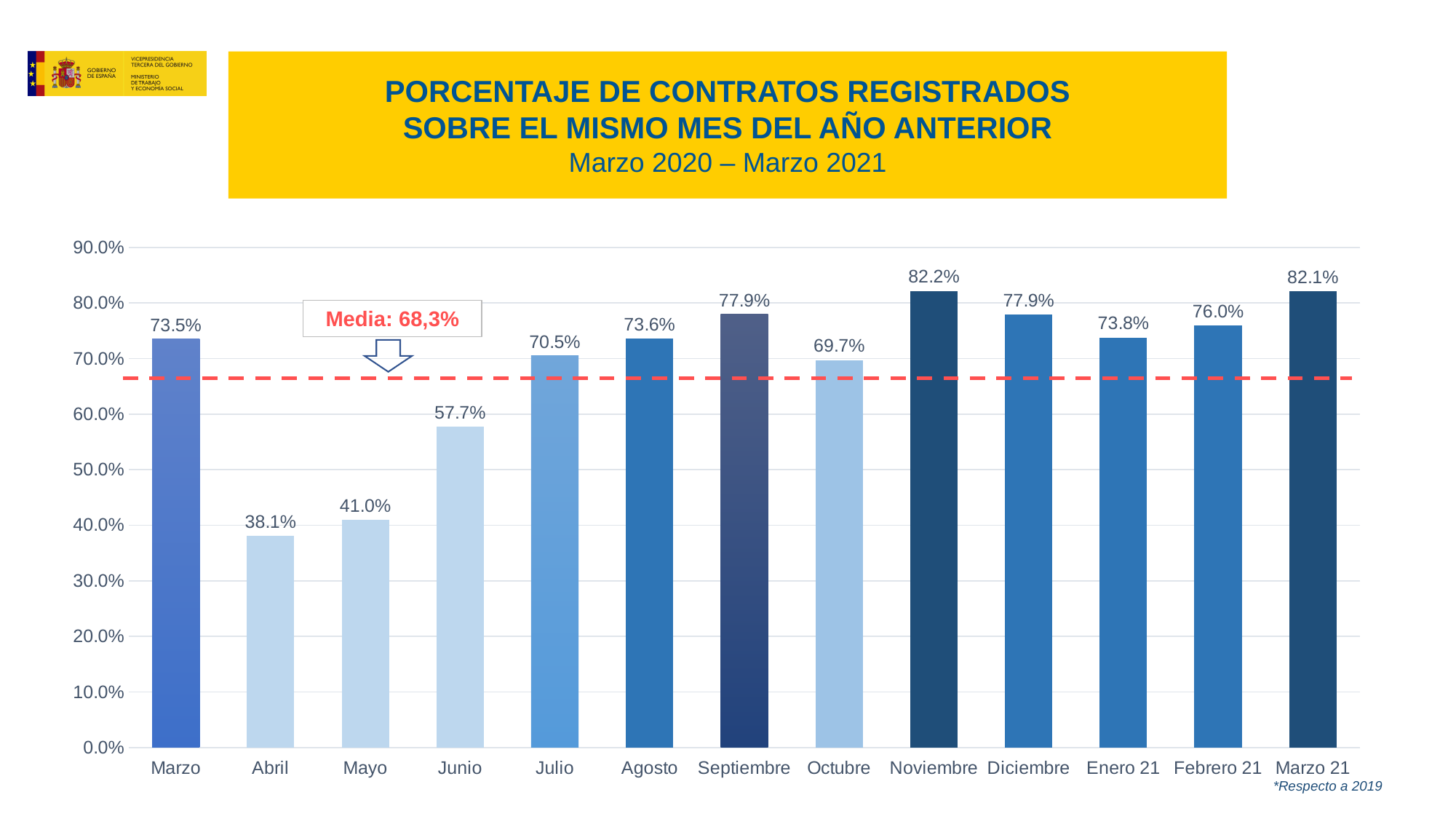
Which is larger, the value for Junio or the value for Julio? Julio What kind of chart is shown on the slide? bar chart Is the value for Junio greater or less than 60%? less Which month has the lowest value? Abril What is the value for Noviembre? 82.2% What average value (Media) is indicated by the dashed red line? 68,3% What is the value for Abril? 38.1% What is the difference between the values for Junio and Mayo? 16.7 percentage points What is the value for Marzo 21? 82.1% Is the value for Septiembre greater or less than 70%? greater What is the difference between the values for Noviembre and Abril? 44.1 percentage points How many months are shown on the x axis? 13